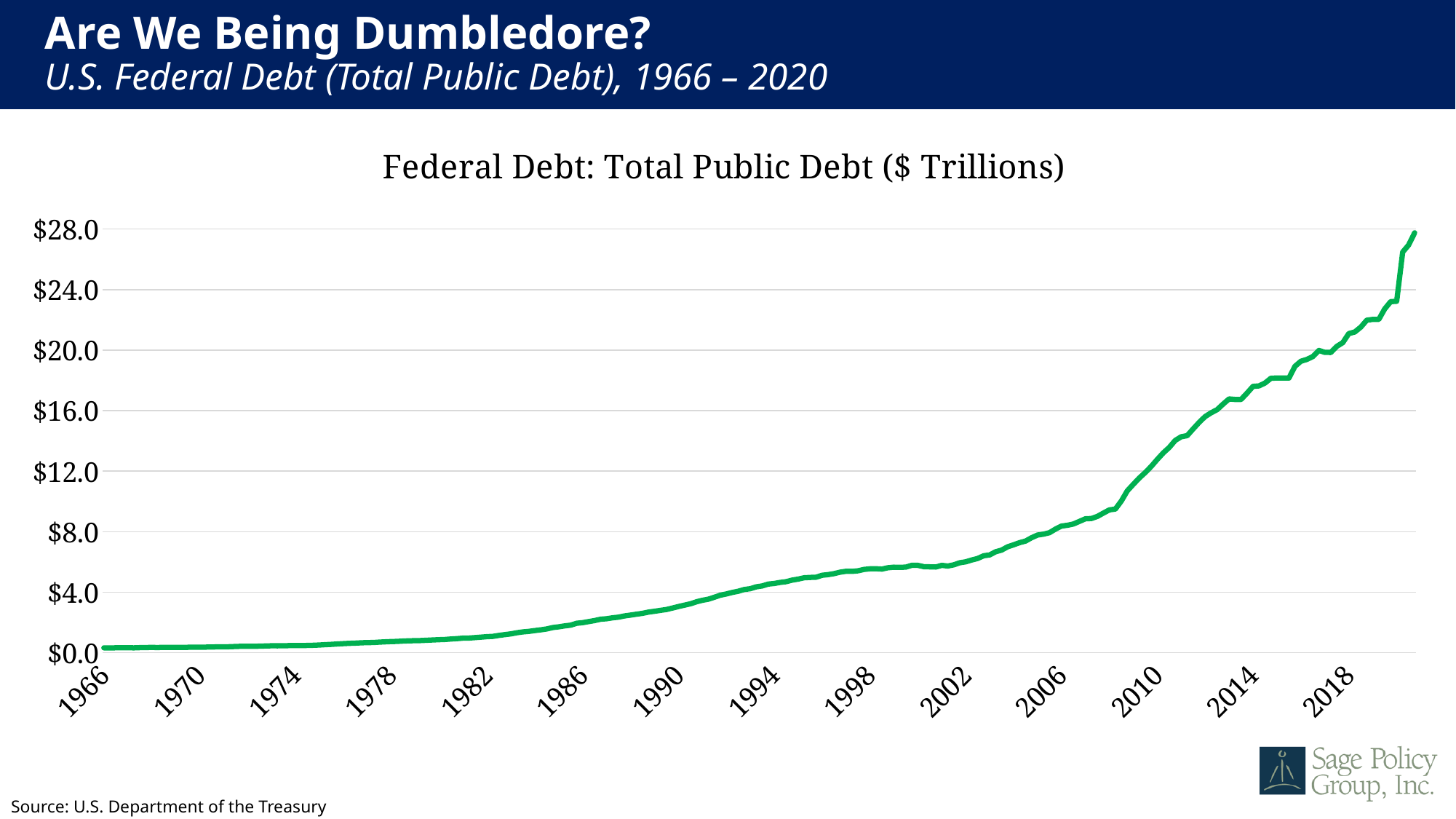
In which year does the line reach its highest value? 2020 Is the value for 2002 greater or less than $8.0? less What source is cited for the chart data? U.S. Department of the Treasury In which year is the federal debt at its lowest? 1966 Does the federal debt generally rise or fall from 1966 to 2020? rise Is the value for 2006 greater or less than $4.0? greater Is the value for 2018 greater or less than $16.0? greater What is the title of the chart? Federal Debt: Total Public Debt ($ Trillions) What kind of chart is shown on the slide? line chart